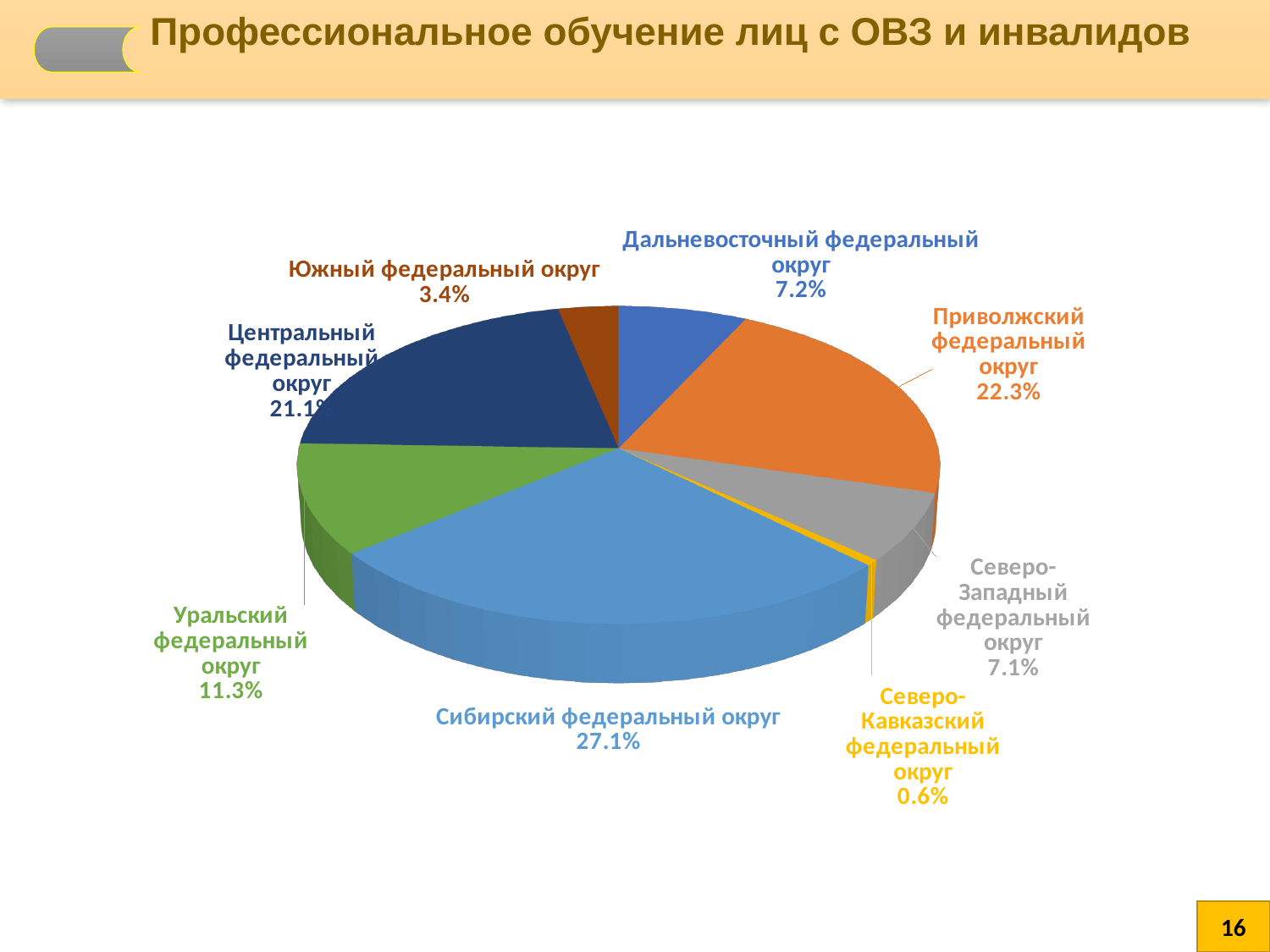
What kind of chart is shown on the slide? pie chart Which federal district has the smallest share in the pie chart? Северо-Кавказский федеральный округ What is the share of Приволжский федеральный округ? 22.3% Which has the larger share: Дальневосточный федеральный округ or Уральский федеральный округ? Уральский федеральный округ How many federal districts (slices) are shown in the pie chart? 8 What is the difference in percentage points between Сибирский федеральный округ and Приволжский федеральный округ? 4.8 What is the share of Северо-Кавказский федеральный округ? 0.6% Which federal district has the largest share in the pie chart? Сибирский федеральный округ What is the title of the slide? Профессиональное обучение лиц с ОВЗ и инвалидов What is the share of Южный федеральный округ? 3.4% What is the share of Уральский федеральный округ? 11.3% What is the share of Сибирский федеральный округ? 27.1%